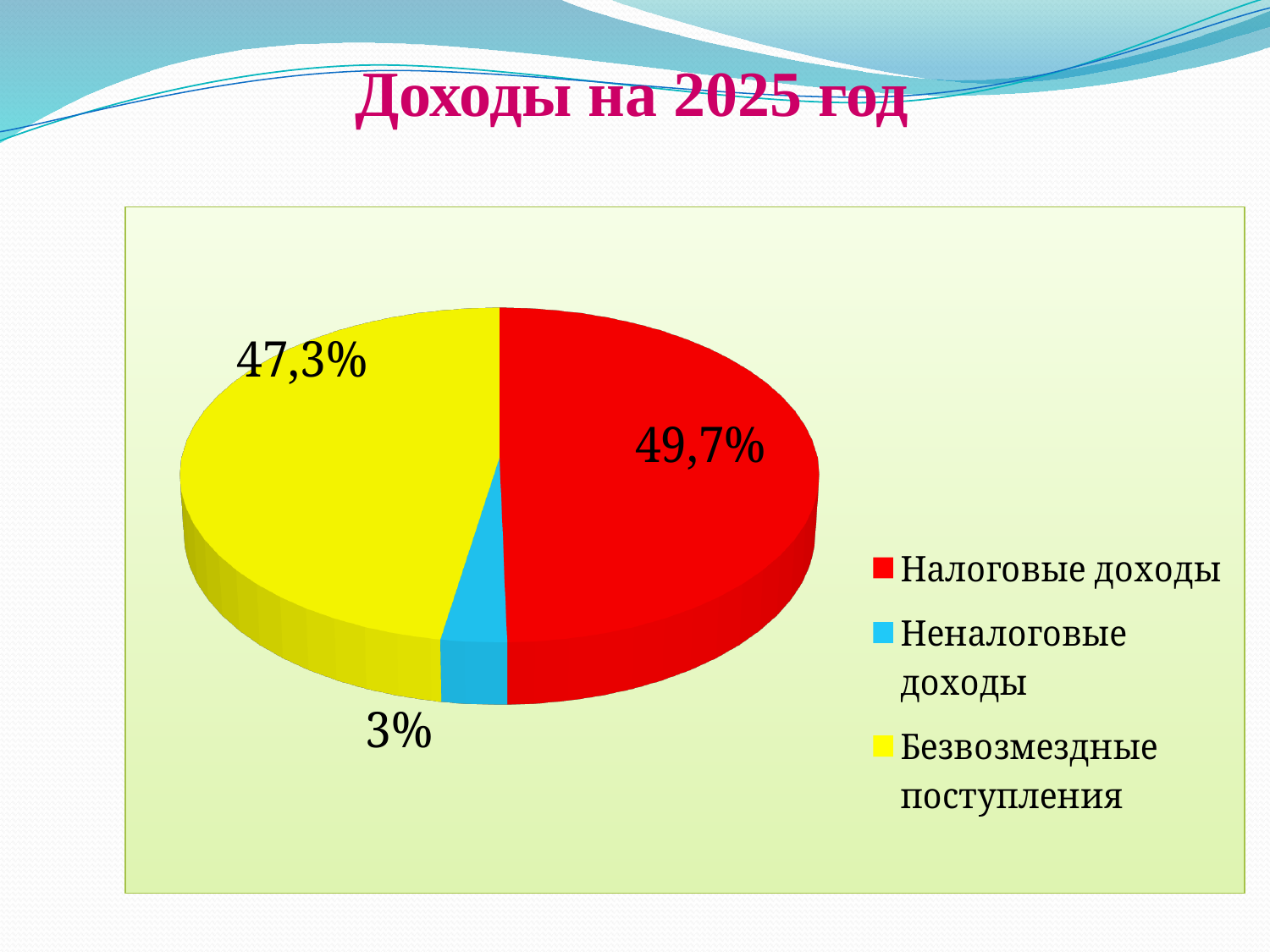
How many categories does the pie chart show? 3 What share of the pie is Налоговые доходы? 49,7% What share of the pie is Безвозмездные поступления? 47,3% What is the difference between the shares of Налоговые доходы and Безвозмездные поступления? 2,4% Which is larger, the share of Налоговые доходы or the share of Неналоговые доходы? Налоговые доходы What share of the pie is Неналоговые доходы? 3% What is the difference between the shares of Безвозмездные поступления and Неналоговые доходы? 44,3% What colour is the slice for Безвозмездные поступления? Yellow Which category has the largest share of the pie? Налоговые доходы What is the title of the chart? Доходы на 2025 год Which category has the smallest share of the pie? Неналоговые доходы What kind of chart is shown on the slide? Pie chart